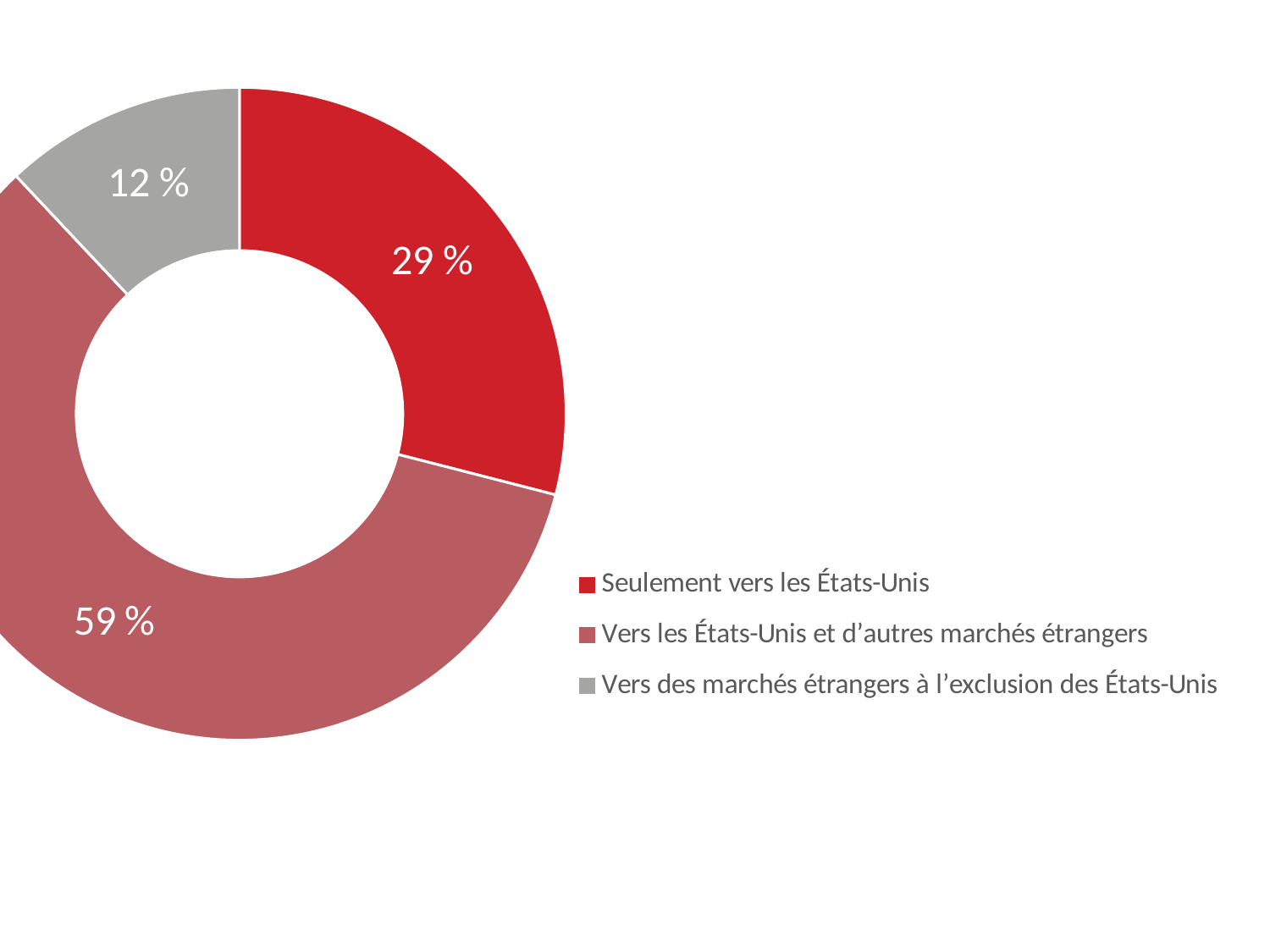
What kind of chart is shown on the slide? Pie chart (doughnut) Which category has the largest share of the pie? Vers les États-Unis et d'autres marchés étrangers Which category has the smallest share of the pie? Vers des marchés étrangers à l'exclusion des États-Unis What is the value for "Vers des marchés étrangers à l'exclusion des États-Unis"? 12 % What colour is the slice for "Vers des marchés étrangers à l'exclusion des États-Unis"? Grey Which legend entry is shown in bright red? Seulement vers les États-Unis How many categories does the chart show? 3 Which is larger: the share for "Seulement vers les États-Unis" or the share for "Vers des marchés étrangers à l'exclusion des États-Unis"? Seulement vers les États-Unis What is the difference between the shares for "Seulement vers les États-Unis" and "Vers des marchés étrangers à l'exclusion des États-Unis"? 17 % What is the difference between the shares for "Vers les États-Unis et d'autres marchés étrangers" and "Seulement vers les États-Unis"? 30 % What share of the pie does "Seulement vers les États-Unis" represent? 29 % What is the value for "Vers les États-Unis et d'autres marchés étrangers"? 59 %